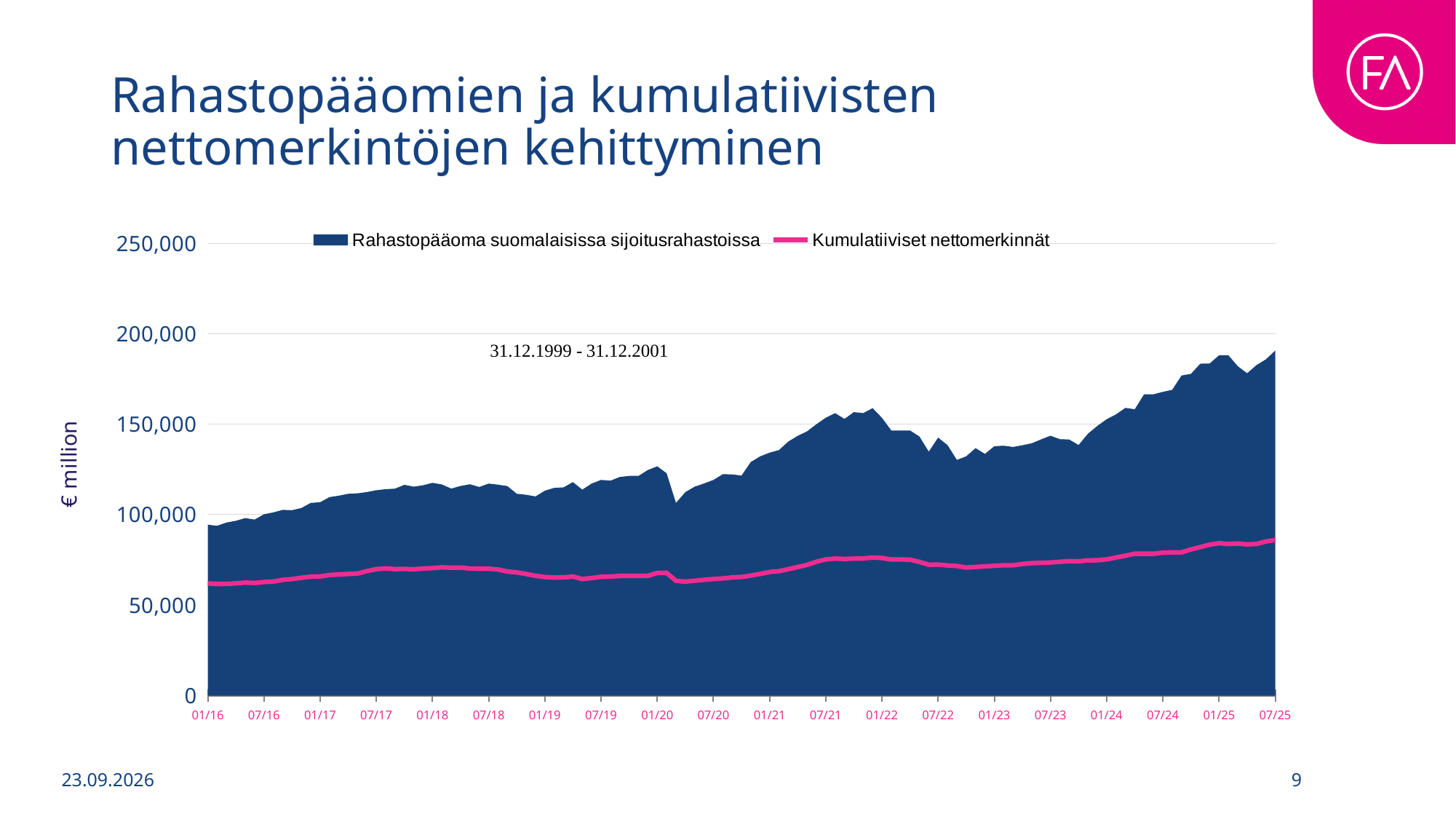
What are the two series named in the legend? Rahastopääoma suomalaisissa sijoitusrahastoissa; Kumulatiiviset nettomerkinnät Does the value of Rahastopääoma suomalaisissa sijoitusrahastoissa generally rise or fall from 01/16 to 07/25? rise How many series does the legend list? 2 Is the value of Rahastopääoma suomalaisissa sijoitusrahastoissa at 01/20 greater or less than 100,000? greater Which series has the higher value at 07/25, Rahastopääoma suomalaisissa sijoitusrahastoissa or Kumulatiiviset nettomerkinnät? Rahastopääoma suomalaisissa sijoitusrahastoissa What is the label on the vertical axis? € million Is the value of Rahastopääoma suomalaisissa sijoitusrahastoissa at 07/25 greater or less than 150,000? greater How many date labels are shown on the x axis? 20 What kind of chart is shown on the slide? Area chart with a line series Is the value of Kumulatiiviset nettomerkinnät at 01/16 greater or less than 50,000? greater